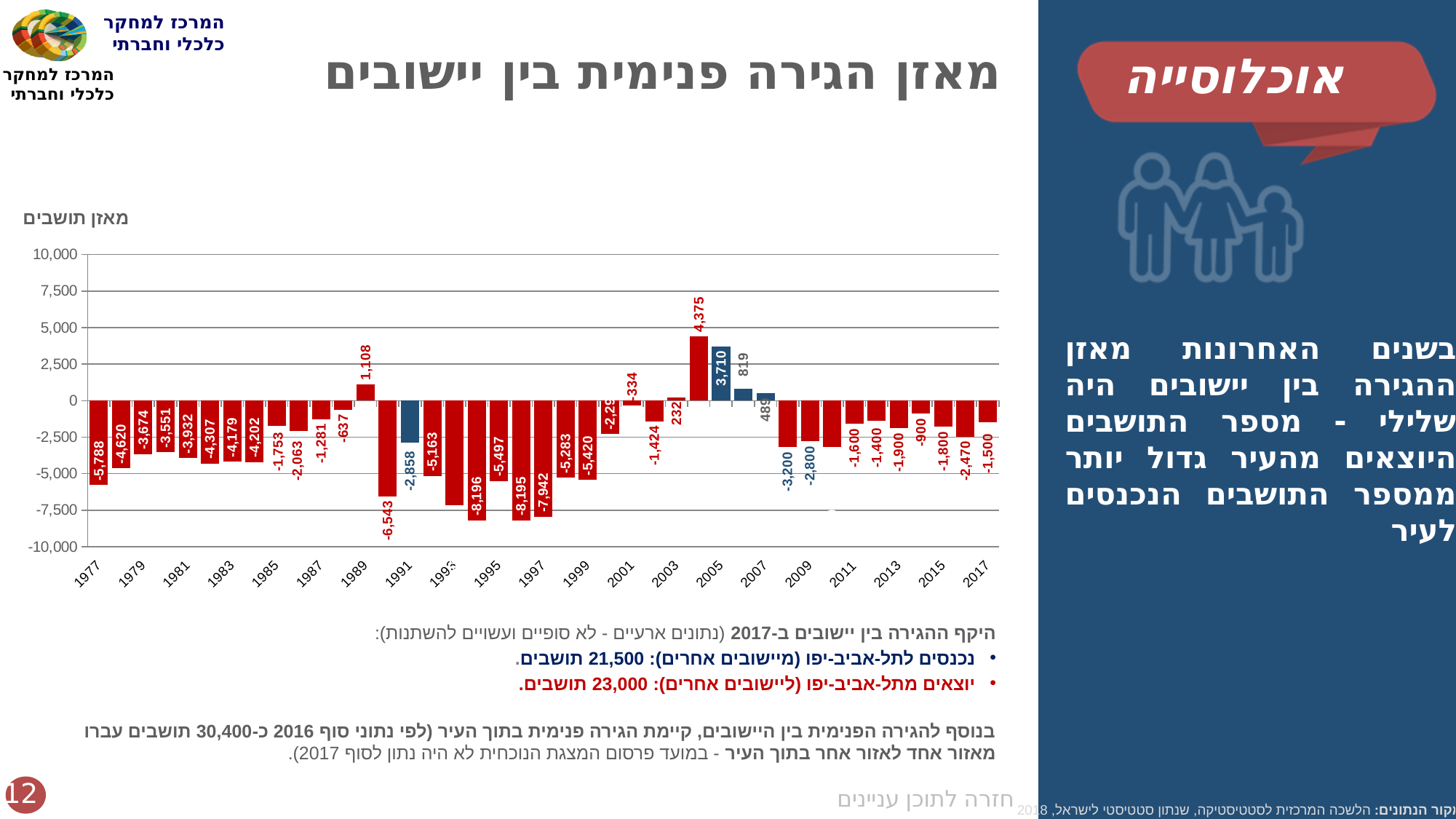
What is the value for 1989? 1,108 What is the value for 1977? -5,788 What type of chart is shown on the slide? bar chart What is the value for 2005? 3,710 What are the first and last years shown on the x axis? 1977 and 2017 What is the value for 2017? -1,500 What is the title of the chart? מאזן הגירה פנימית בין יישובים Which year has the larger value, 1977 or 2017? 2017 What is the y-axis label of the chart? מאזן תושבים What is the difference between the values for 2004 (4,375) and 2005 (3,710)? 665 What is the highest value shown in the chart? 4,375 How many bars in the chart have a positive value? 6